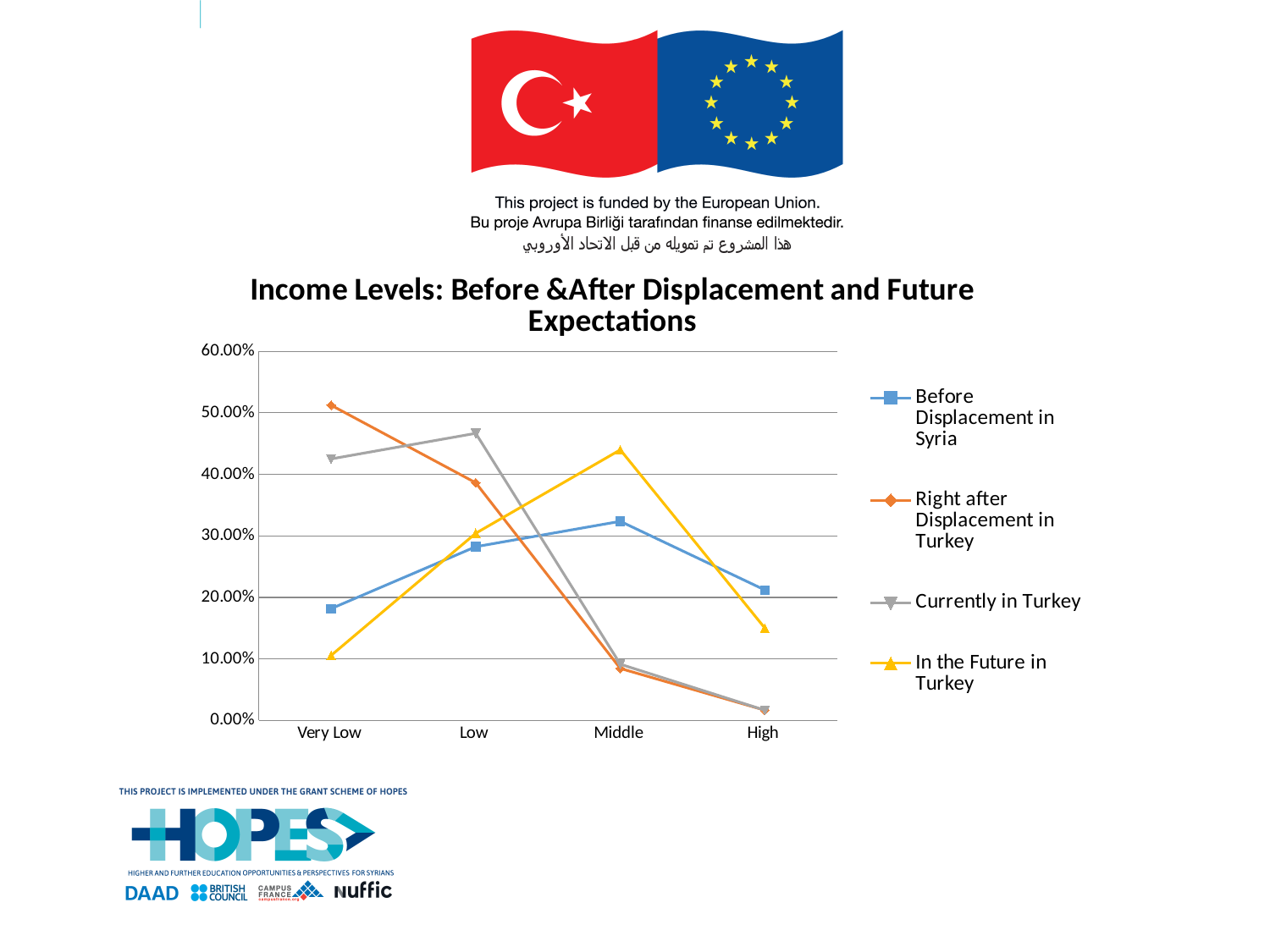
How many series does the legend list? 4 What kind of chart is shown on the slide? line chart How many income level categories are shown on the x axis? 4 For the 'In the Future in Turkey' series, which income level has the highest value? Middle Is the value for 'Right after Displacement in Turkey' at Very Low greater or less than 40.00%? greater At the Middle income level, which series has the larger value: 'In the Future in Turkey' or 'Before Displacement in Syria'? In the Future in Turkey What is the title of the chart? Income Levels: Before &After Displacement and Future Expectations For the 'Before Displacement in Syria' series, which income level has the highest value? Middle For the 'Right after Displacement in Turkey' series, which income level has the highest value? Very Low Is the value for 'In the Future in Turkey' at Very Low greater or less than 20.00%? less Does the 'Right after Displacement in Turkey' series rise or fall from Very Low to High? fall